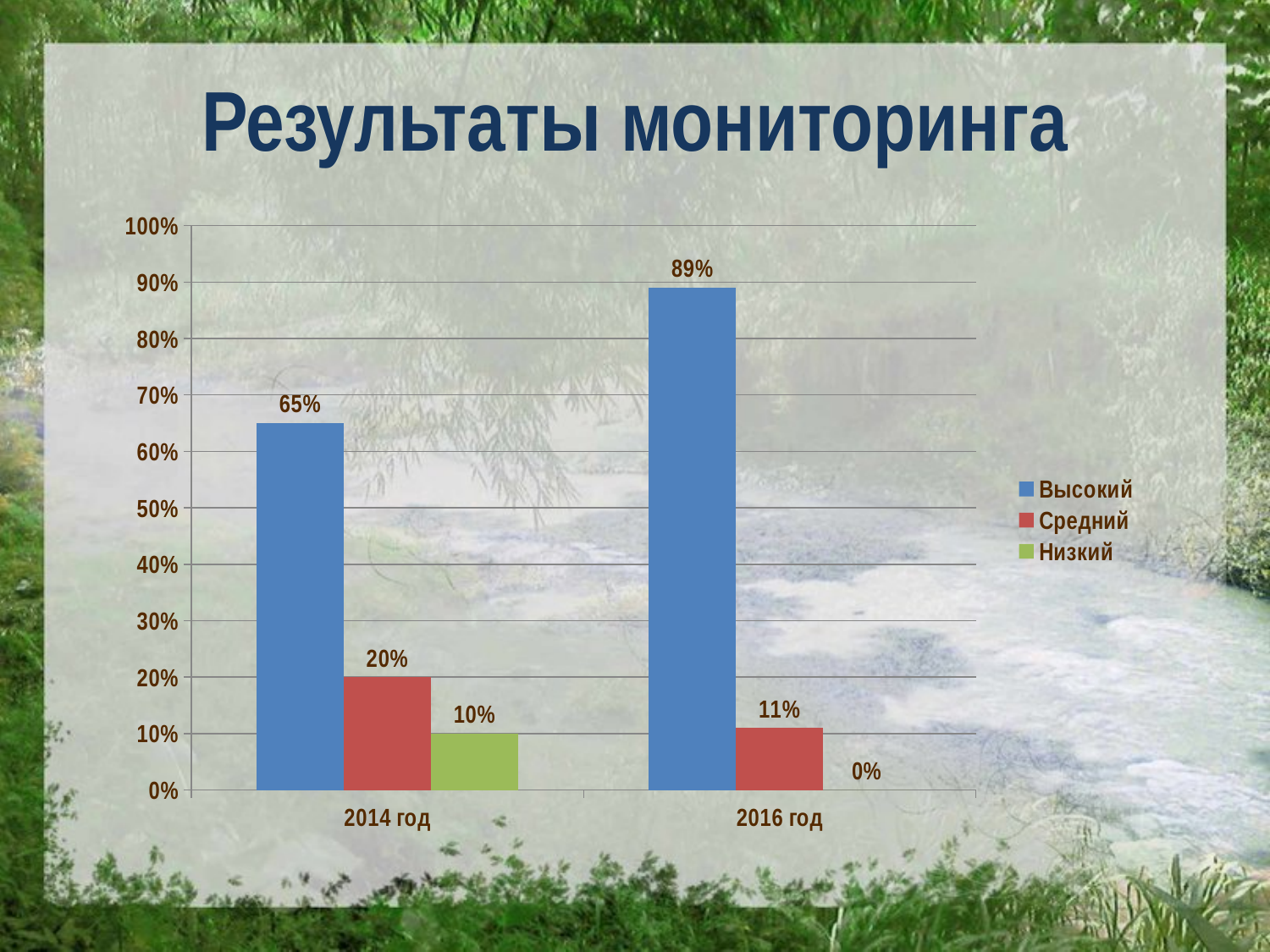
How many categories are shown on the x axis? 2 What is the value for Низкий in 2016 год? 0% What kind of chart is shown on the slide? Bar chart What is the value for Низкий in 2014 год? 10% What is the title of the slide? Результаты мониторинга Which series has the lowest value in 2016 год? Низкий What is the difference between the Высокий values for 2016 год and 2014 год? 24% How many series does the legend list? 3 What is the value for Высокий in 2014 год? 65% What is the value for Средний in 2016 год? 11% Which category has the highest value for Высокий? 2016 год Which is larger: Средний in 2014 год or Средний in 2016 год? 2014 год